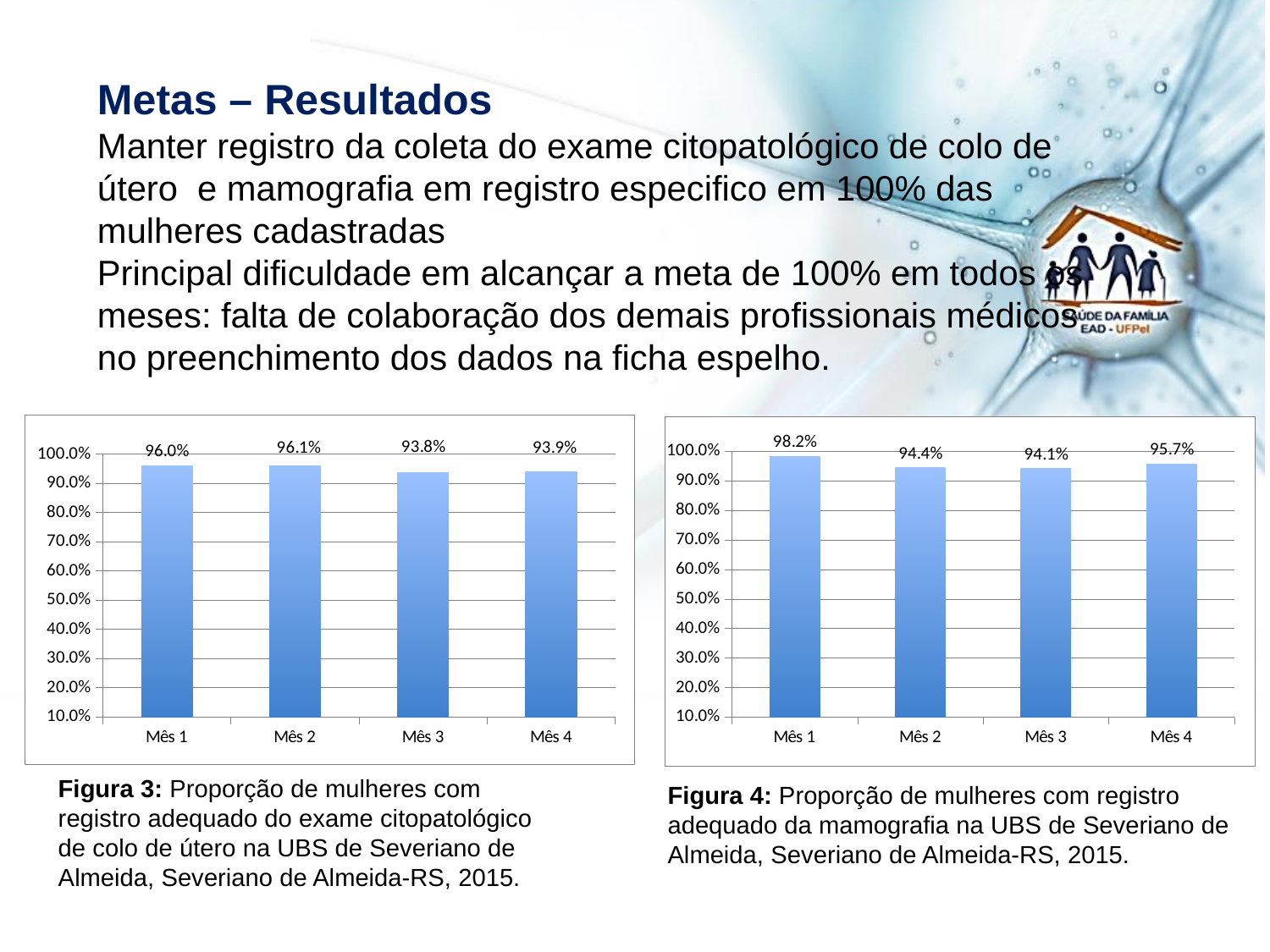
In the left chart (Figura 3), which is larger, the value for Mês 2 or the value for Mês 3? Mês 2 What type of chart is the right chart (Figura 4)? Bar chart How many months are shown on the x axis of the left chart (Figura 3)? 4 In the left chart (Figura 3), what is the difference between the values for Mês 1 and Mês 3? 2.2 percentage points In the right chart (Figura 4), what is the difference between the values for Mês 1 and Mês 2? 3.8 percentage points In the right chart (Figura 4), what is the value for Mês 4? 95.7% In the right chart (Figura 4), what is the value for Mês 1? 98.2% In the right chart (Figura 4), which month has the highest value? Mês 1 In the left chart (Figura 3), is the value for Mês 4 greater or less than 90.0%? greater In the right chart (Figura 4), which is larger, the value for Mês 1 or the value for Mês 3? Mês 1 In the left chart (Figura 3), what is the value for Mês 3? 93.8% In the left chart (Figura 3), what is the value for Mês 1? 96.0%